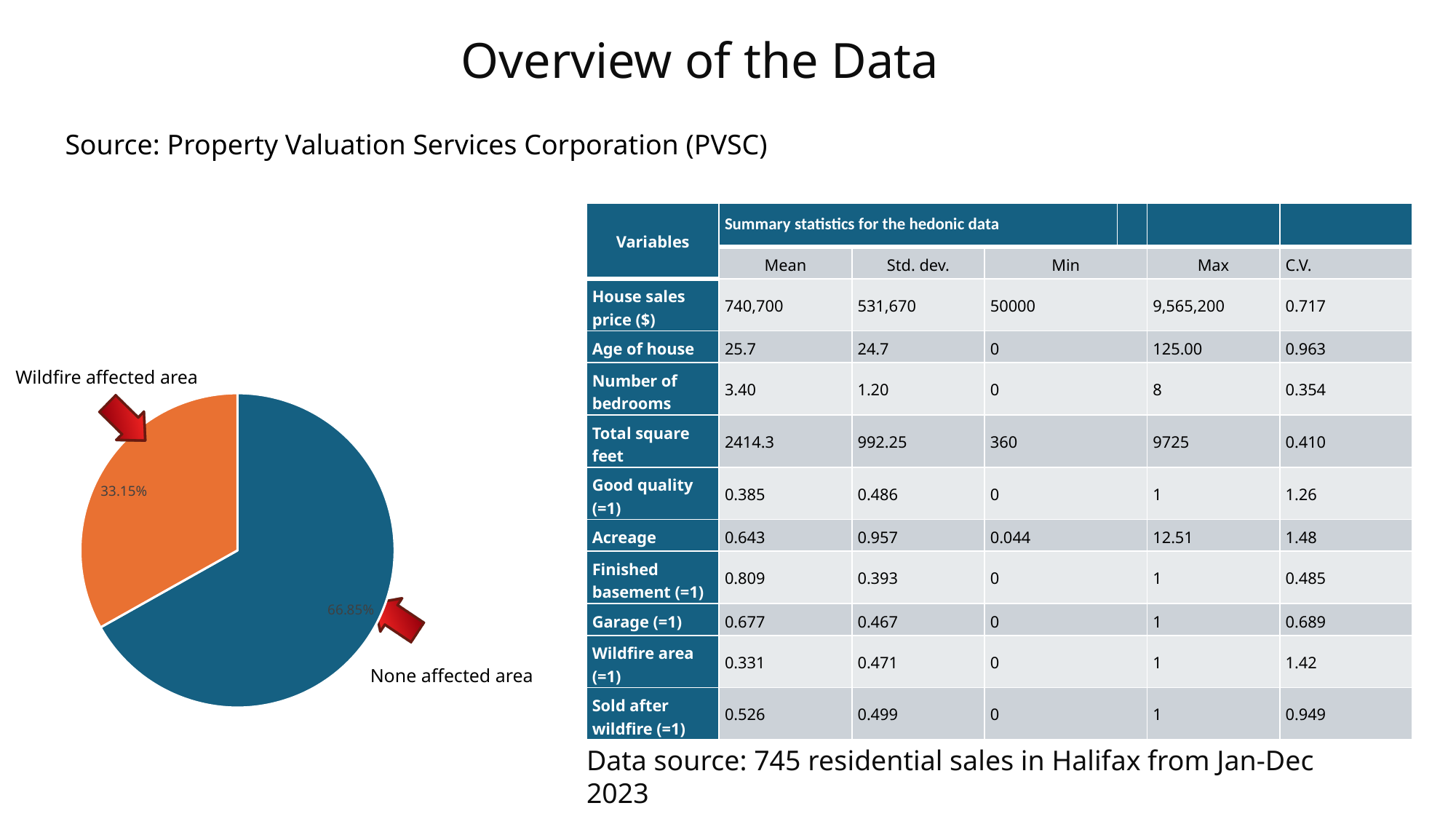
What is the difference in percentage points between the none affected area slice and the wildfire affected area slice in the pie chart? 33.70 What colour is the none affected area slice in the pie chart? blue In the pie chart, what share is labelled for the none affected area? 66.85% Which slice of the pie chart is the smallest? Wildfire affected area What colour is the wildfire affected area slice in the pie chart? orange In the pie chart, what share is labelled for the wildfire affected area? 33.15% How many slices does the pie chart have? 2 Which slice of the pie chart is the largest? None affected area In the pie chart, which is larger: the wildfire affected area slice or the none affected area slice? None affected area What kind of chart is shown on the left of the slide? pie chart